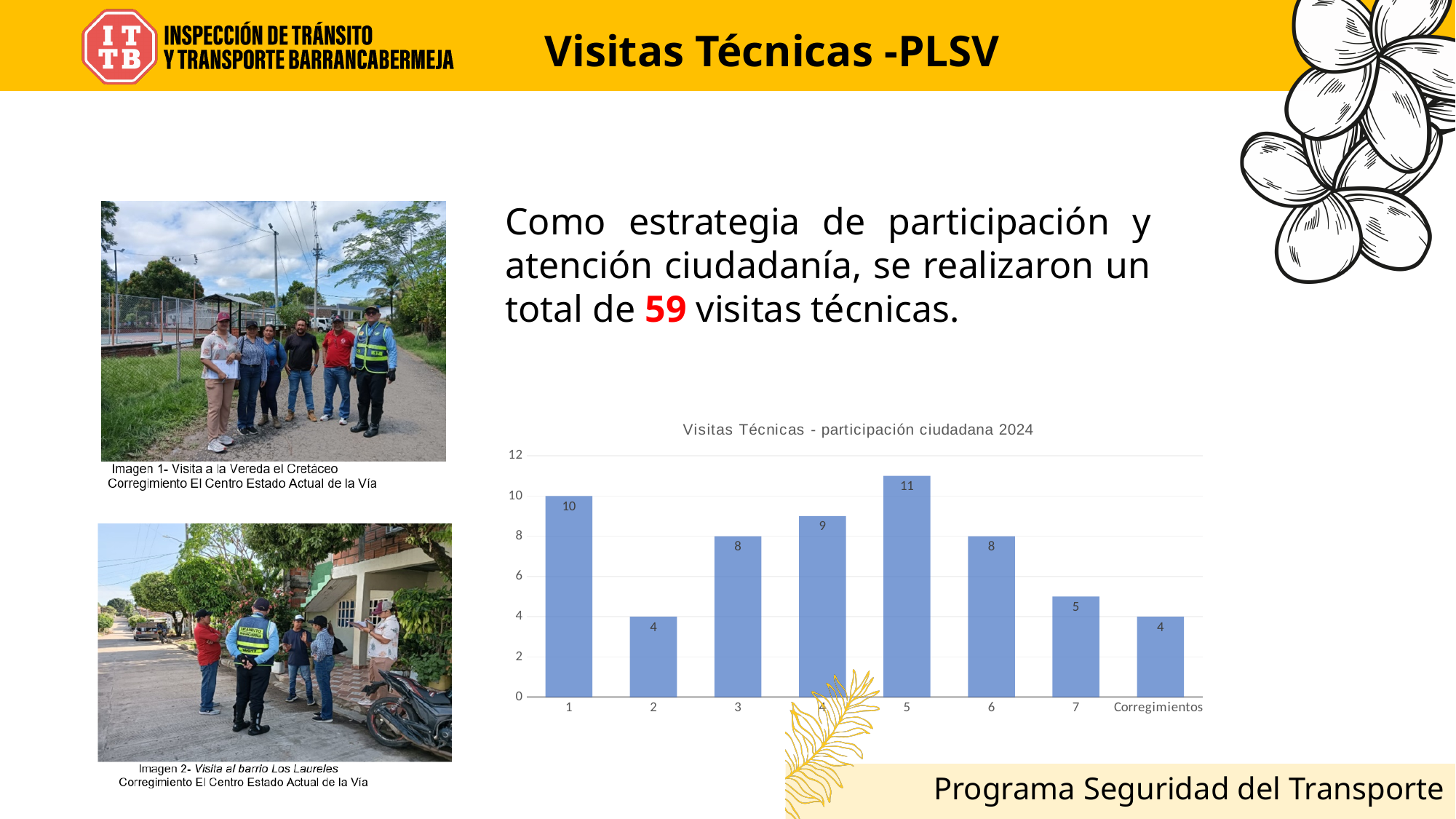
What is the value for category 1? 10 Which category has the highest value? 5 How many categories are plotted on the x axis of the chart? 8 What is the title of the chart? Visitas Técnicas - participación ciudadana 2024 What type of chart is shown on the slide? bar chart Which is larger, the value for category 4 or the value for category 6? category 4 What is the total of all the bars in the chart? 59 What is the difference between the values for category 5 and category 7? 6 What is the value for category 5? 11 What is the value for category 2? 4 Is the value for category 3 greater or less than 6? greater What is the value for Corregimientos? 4